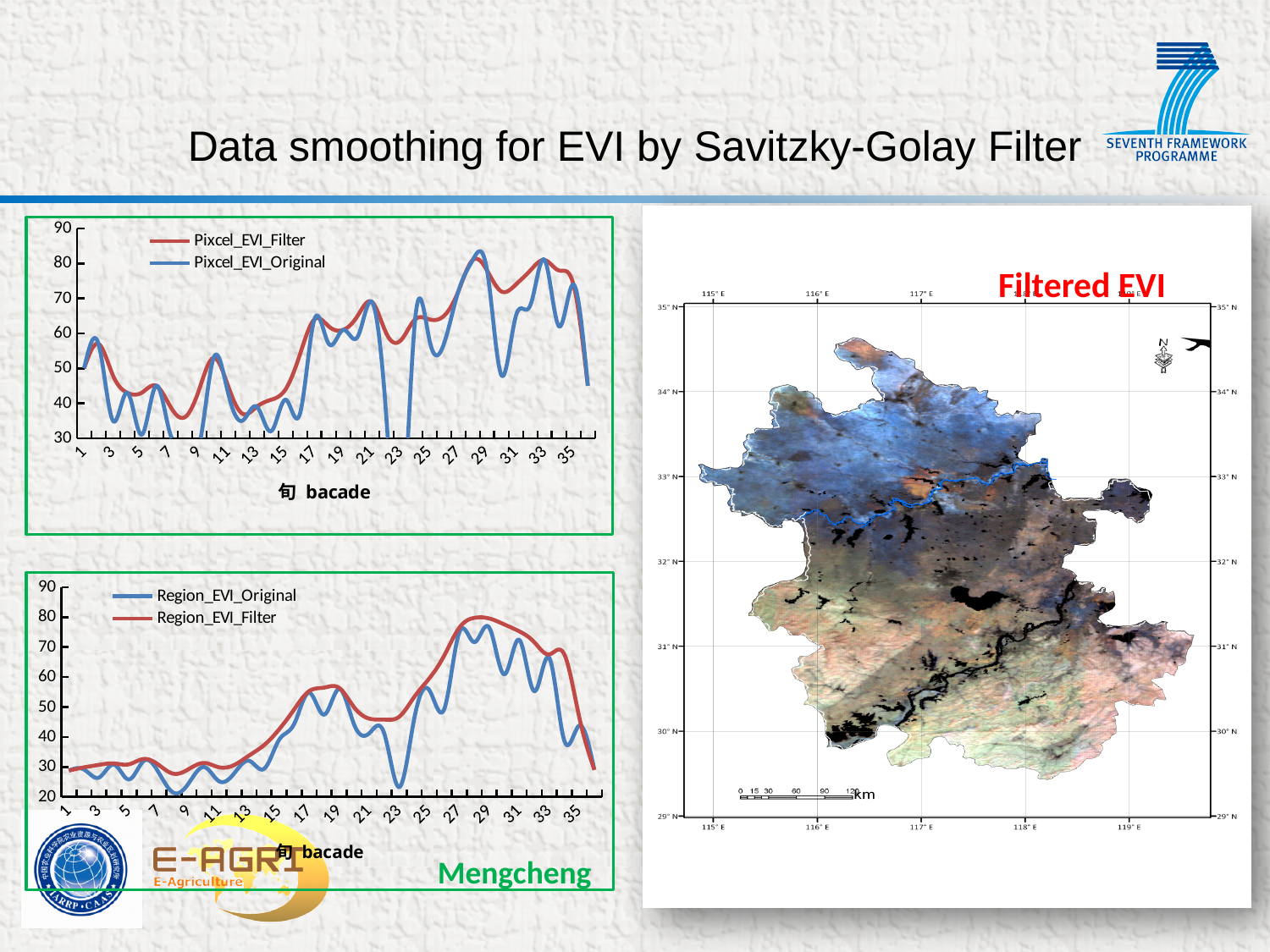
In the bottom chart, is the value of Region_EVI_Filter at bacade 1 greater or less than 40? less In the bottom chart, at bacade 23, which series has the higher value, Region_EVI_Filter or Region_EVI_Original? Region_EVI_Filter In the top chart, does Pixcel_EVI_Filter rise or fall from bacade 13 to bacade 17? rise In the bottom chart, does Region_EVI_Filter rise or fall from bacade 29 to bacade 35? fall What kind of chart is the top chart on the left of the slide? line chart In the top chart, is the value of Pixcel_EVI_Original at bacade 1 greater or less than 40? greater In the top chart, at bacade 23, which series has the higher value, Pixcel_EVI_Filter or Pixcel_EVI_Original? Pixcel_EVI_Filter In the bottom chart, which series is drawn in blue? Region_EVI_Original How many series does the legend of the top chart list? 2 In the top chart, which series is drawn in red? Pixcel_EVI_Filter In the bottom chart, is the value of Region_EVI_Original at bacade 23 greater or less than 30? less How many series does the legend of the bottom chart list? 2